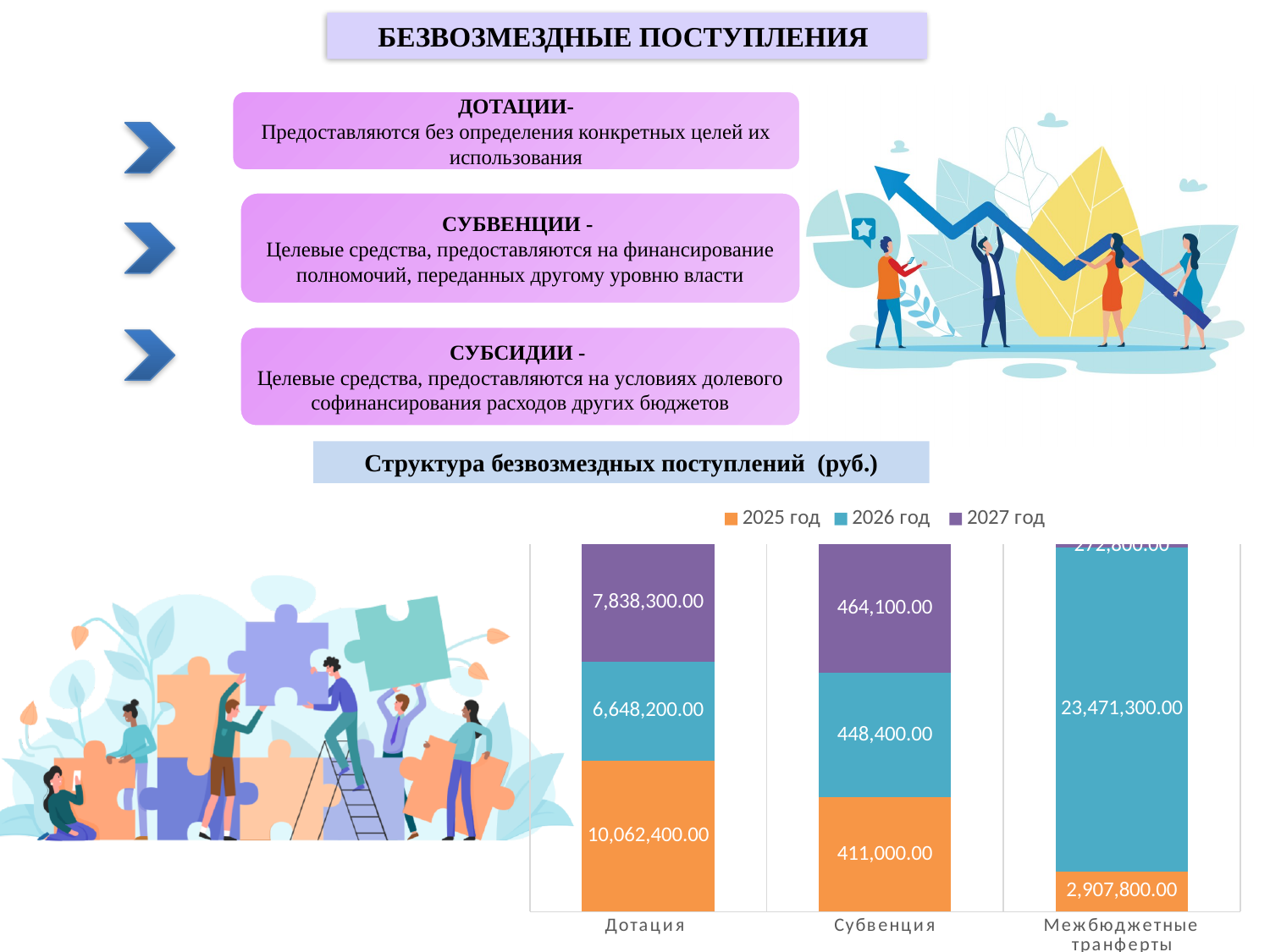
How many categories are shown on the x axis of the chart? 3 Which year has the highest value for Дотация? 2025 год How many series does the chart legend list? 3 Which year has the lowest value for Субвенция? 2025 год What kind of chart is shown on the slide? Stacked bar chart What is the value for Межбюджетные трансферты in the 2026 год series? 23,471,300.00 What is the value for Субвенция in the 2026 год series? 448,400.00 What is the value for Дотация in the 2027 год series? 7,838,300.00 Which is larger: the 2026 год value for Дотация or the 2026 год value for Межбюджетные трансферты? Межбюджетные трансферты What is the value for Дотация in the 2025 год series? 10,062,400.00 What is the total of the stacked bar for Субвенция? 1,323,500.00 What is the difference between the 2025 год and 2026 год values for Дотация? 3,414,200.00